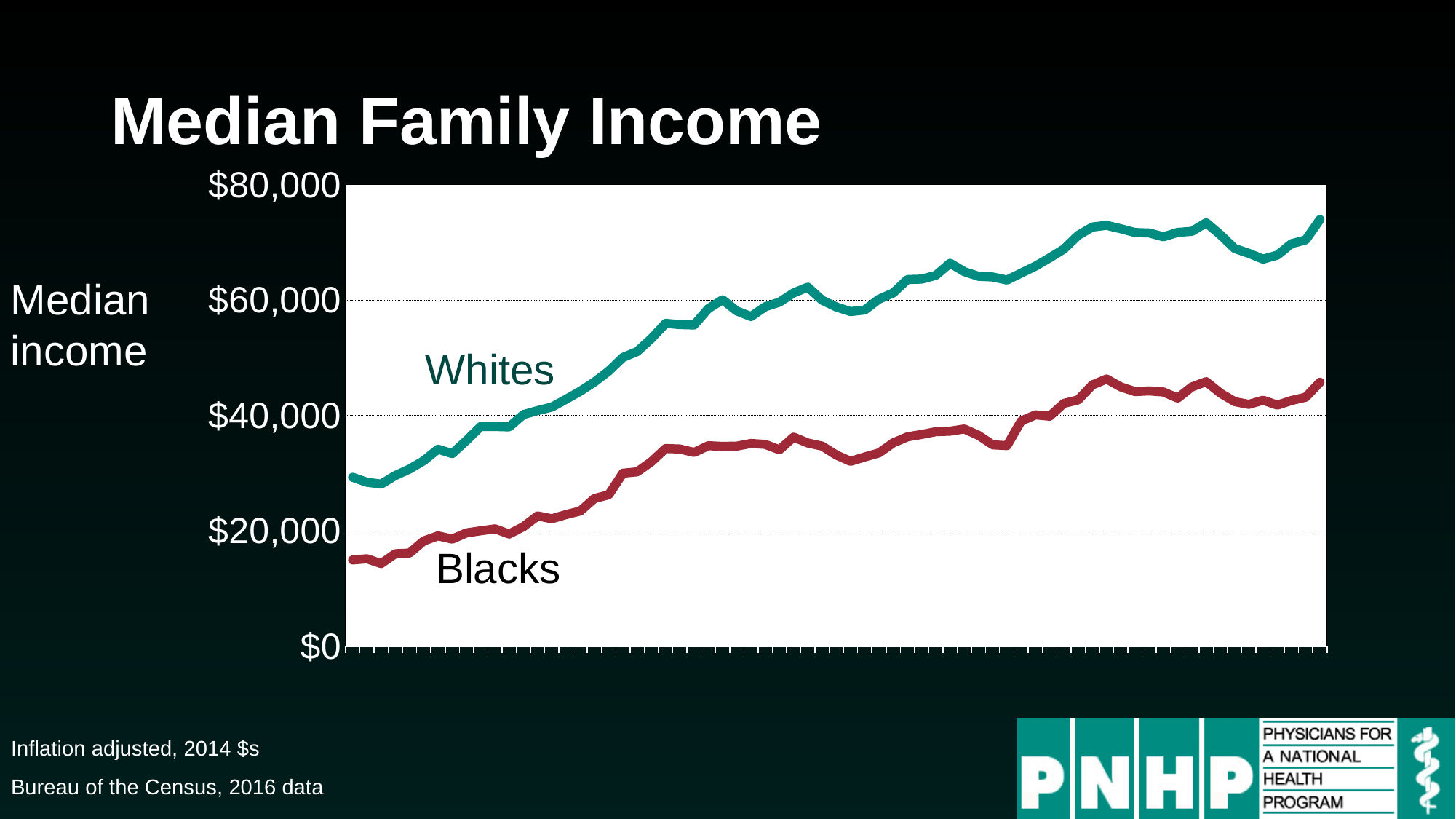
Is the value for Blacks at the right end of the chart greater or less than $40,000? greater Does the median income for Whites generally rise or fall from left to right across the chart? rise Which series is plotted in teal (green)? Whites Is the value for Blacks at the left end of the chart greater or less than $20,000? less What kind of chart is shown on the slide? line chart Is the highest value reached by the Blacks series greater or less than $60,000? less Which series has the higher median income throughout the chart, Whites or Blacks? Whites Does the median income for Blacks generally rise or fall from left to right across the chart? rise What is the title of the chart? Median Family Income How many series are plotted on the chart? 2